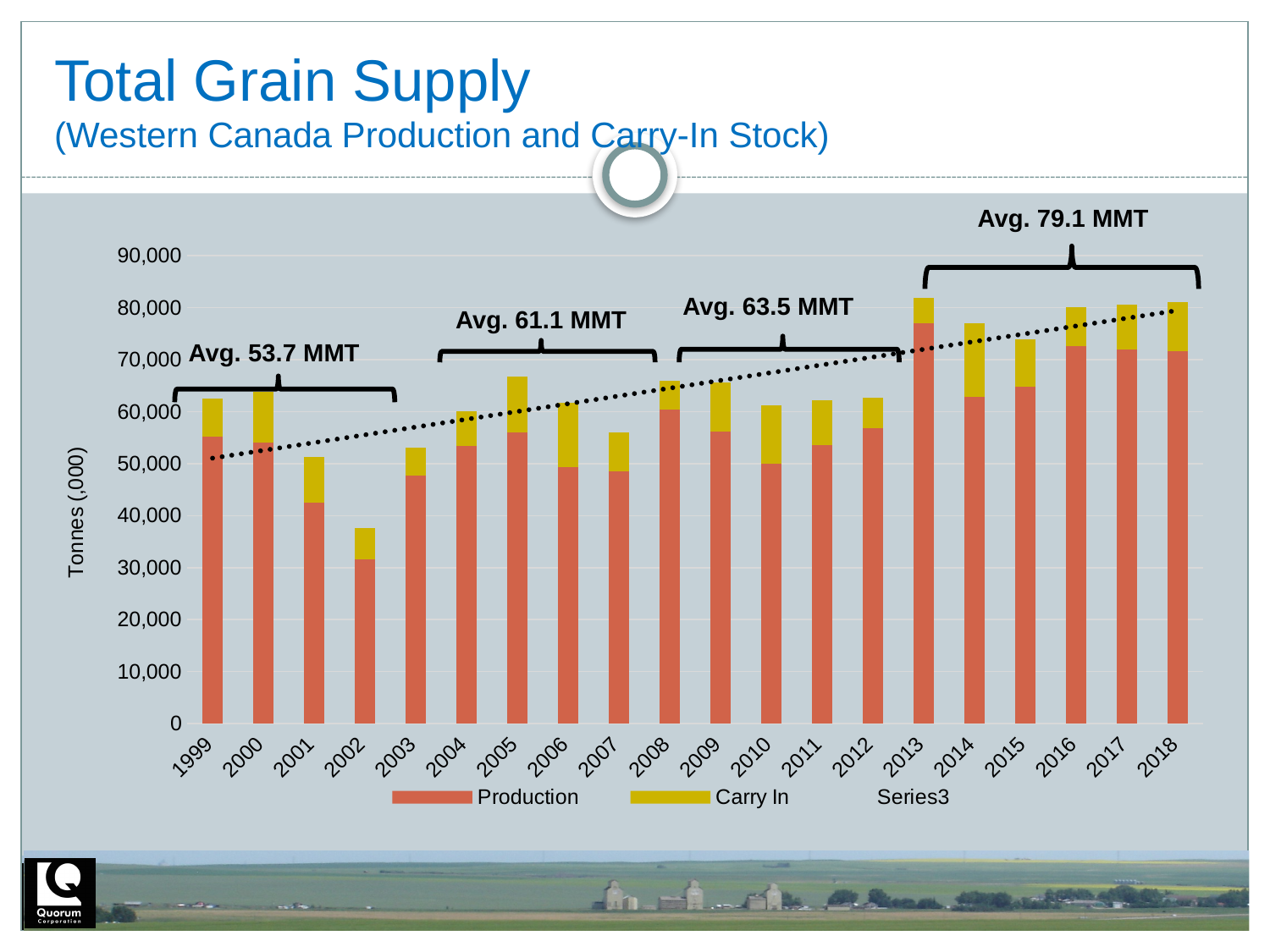
Is the Production value for 2016 greater or less than 70,000? greater What average is annotated above the 2013–2018 bars? Avg. 79.1 MMT Is the total bar for 2013 greater or less than 80,000? greater What is the label on the y axis? Tonnes (,000) Is the Production value for 2001 greater or less than 50,000? less Does the dotted trend line rise or fall from 1999 to 2018? rise How many entries does the legend list? 3 Which year has the larger total bar, 2013 or 2002? 2013 What kind of chart is shown on the slide? Stacked bar chart Which year has the lowest total grain supply? 2002 How many years are plotted along the x axis? 20